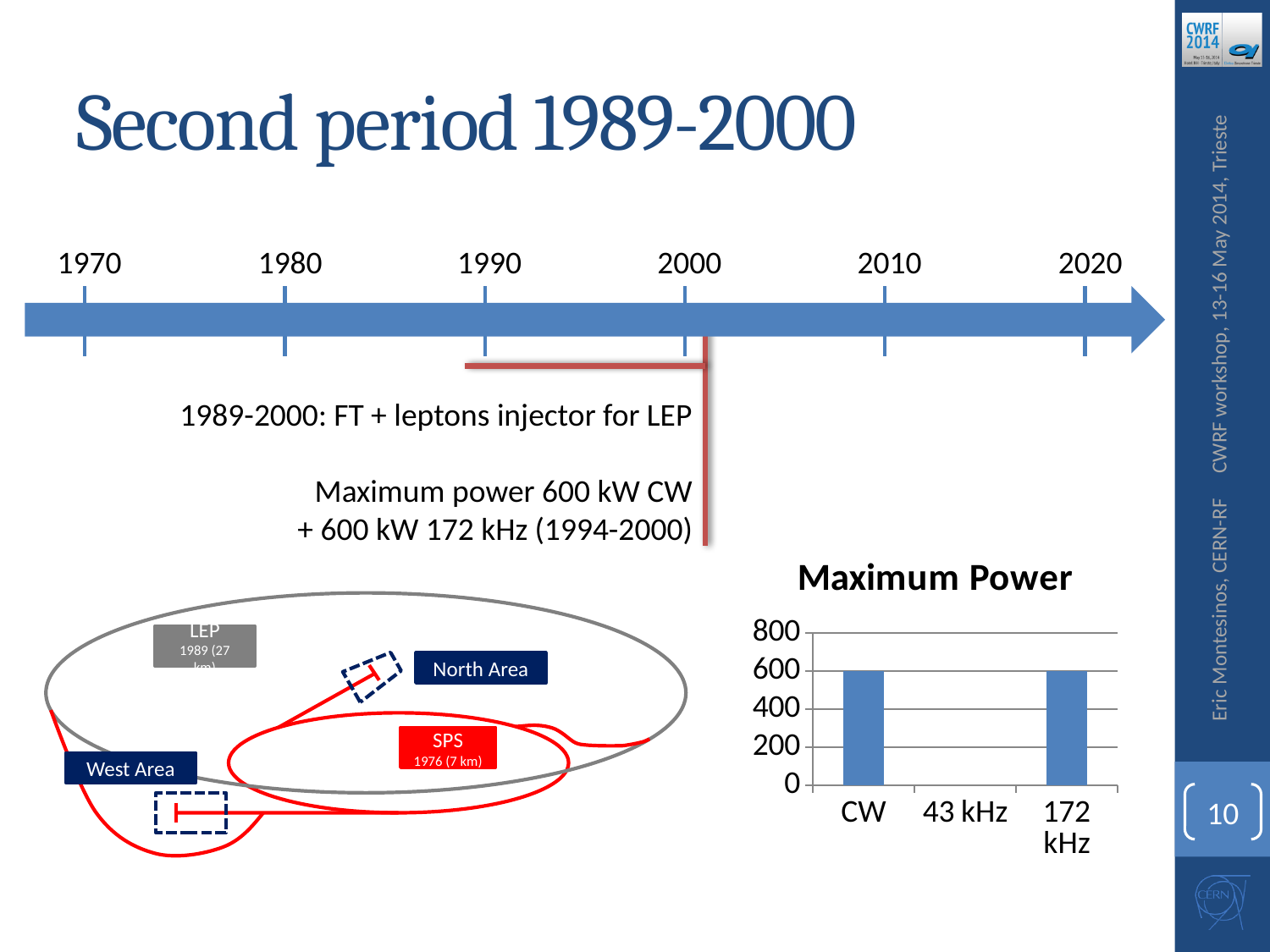
What is the title of the chart on the slide? Maximum Power In the "Maximum Power" chart, is the value for CW greater or less than 400? greater In the "Maximum Power" chart, what is the value for 172 kHz? 600 In the "Maximum Power" chart, is the value for 43 kHz greater or less than 200? less In the "Maximum Power" chart, what is the difference between the values for CW and 172 kHz? 0 How many categories are shown on the x axis of the "Maximum Power" chart? 3 What kind of chart is the "Maximum Power" chart? bar chart In the "Maximum Power" chart, how many categories have a visible bar? 2 What is the highest value shown on the y axis of the "Maximum Power" chart? 800 In the "Maximum Power" chart, what is the value for CW? 600 In the "Maximum Power" chart, which category has the lowest value? 43 kHz In the "Maximum Power" chart, is the value for 172 kHz greater or less than 800? less